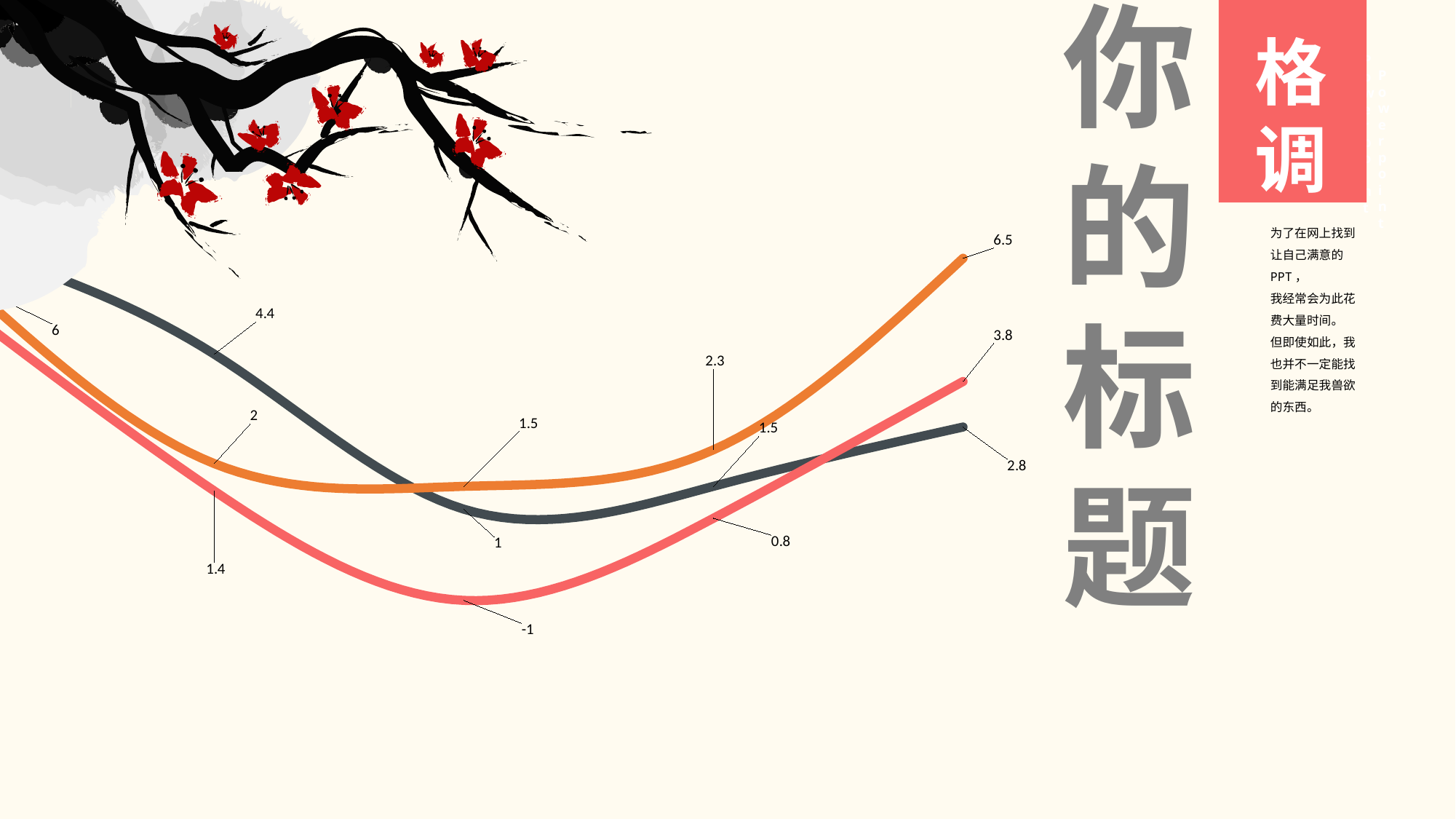
What is the value labelled at the right-hand end of the dark gray line? 2.8 What is the lowest value labelled on the red line? -1 What is the highest value labelled anywhere on the chart? 6.5 What is the difference between the final value of the orange line (6.5) and the final value of the red line (3.8)? 2.7 At the right-hand end of the chart, which line is higher: the orange line or the dark gray line? orange line What is the value labelled at the right-hand end of the red line? 3.8 Does the red line rise or fall from its lowest point (-1) to its right-hand end? rises How many lines are plotted on the chart? 3 What is the value labelled at the right-hand end of the orange line? 6.5 What kind of chart is shown on the slide? line chart